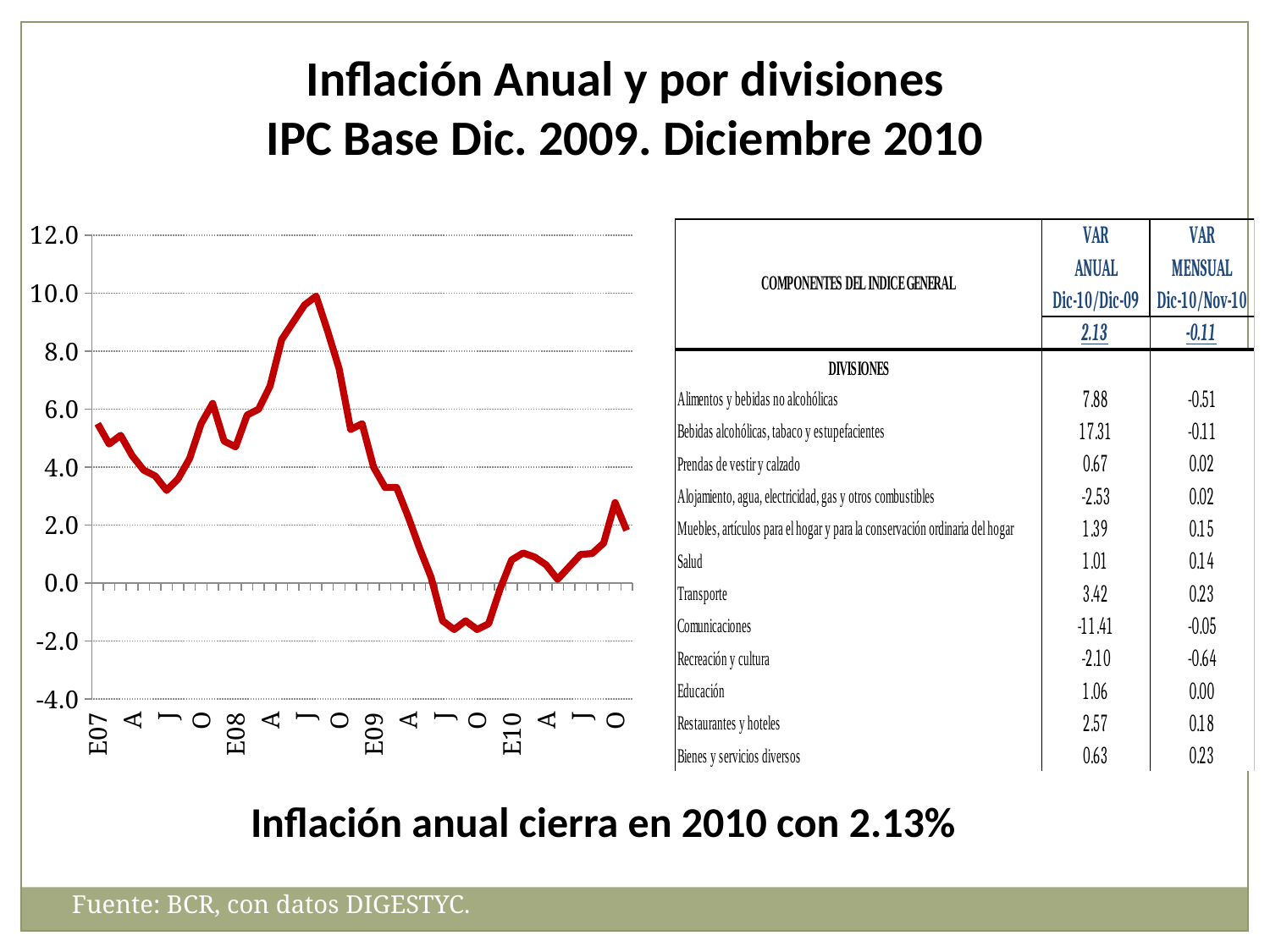
In the line chart, is the peak value reached in 2008 greater or less than 8.0? greater How many lines are plotted in the chart on the left? 1 In the line chart, is the value at E07 greater or less than 4.0? greater In the line chart, is the value at the last point (O10) greater or less than 0.0? greater What is the highest value shown on the y axis of the line chart? 12.0 In the line chart, does the line rise or fall between its 2008 peak and mid-2009? fall In which year does the line chart reach its highest value? 2008 How many labels are shown along the x axis of the line chart? 16 What kind of chart is shown on the left of the slide? line chart Which of the two is larger in the line chart: the value at E07 or the value at J09? E07 What is the lowest value shown on the y axis of the line chart? -4.0